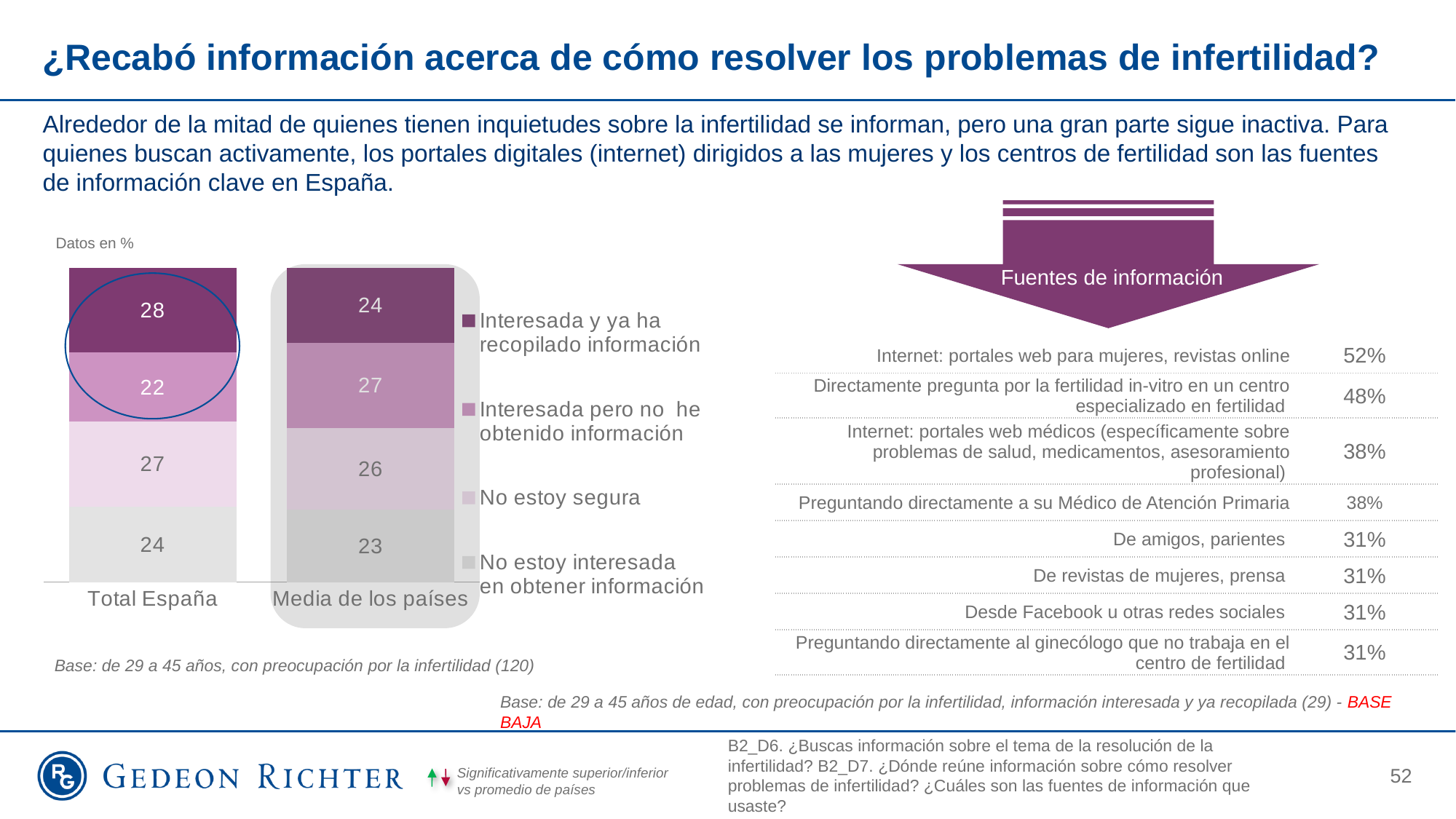
What kind of chart is shown on the left of the slide? Stacked bar chart In the stacked bar chart, what is the difference between Total España and Media de los países for 'Interesada y ya ha recopilado información'? 4 In the stacked bar chart, what is the total of the Total España bar? 101 In the stacked bar chart, what is the value for 'Interesada pero no he obtenido información' for Media de los países? 27 In the stacked bar chart, which segment has the highest value within the Total España bar? Interesada y ya ha recopilado información In the stacked bar chart, what is the value for 'Interesada y ya ha recopilado información' for Total España? 28 How many series does the legend of the stacked bar chart list? 4 How many categories are shown on the x axis of the stacked bar chart? 2 In the stacked bar chart, which category has the larger value for 'Interesada pero no he obtenido información', Total España or Media de los países? Media de los países In the stacked bar chart, what is the total of the Media de los países bar? 100 In the stacked bar chart, what is the value for 'No estoy interesada en obtener información' for Total España? 24 In the stacked bar chart, what is the value for 'No estoy segura' for Media de los países? 26